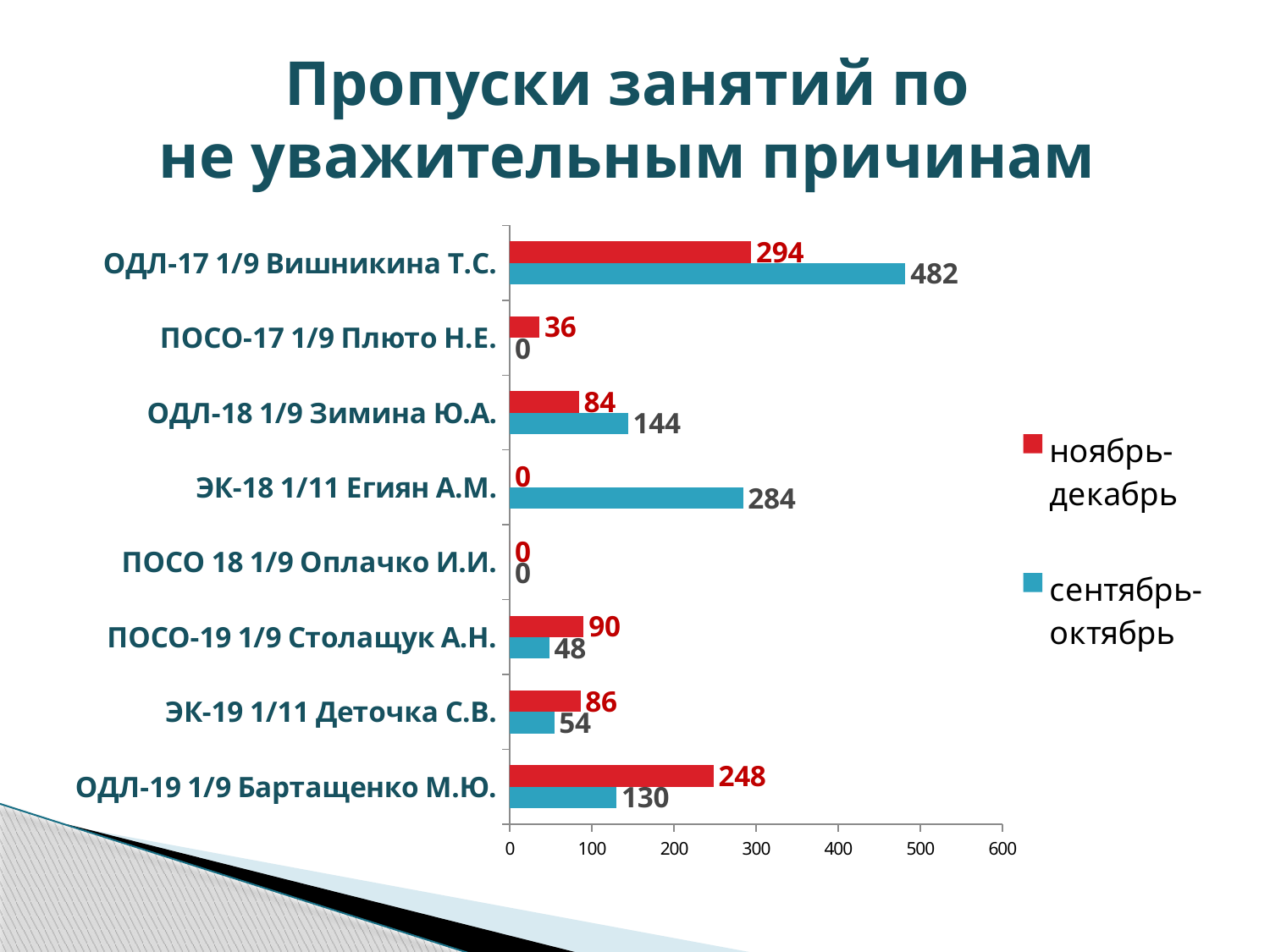
Which category has the highest value in the ноябрь-декабрь series? ОДЛ-17 1/9 Вишникина Т.С. Which category has the highest value in the сентябрь-октябрь series? ОДЛ-17 1/9 Вишникина Т.С. How many categories are shown on the chart? 8 What is the difference between the ноябрь-декабрь and сентябрь-октябрь values for ОДЛ-19 1/9 Бартащенко М.Ю.? 118 What is the value for ОДЛ-19 1/9 Бартащенко М.Ю. in the ноябрь-декабрь series? 248 What kind of chart is shown on the slide? bar chart How many series does the legend list? 2 For ПОСО-19 1/9 Столащук А.Н., which series has the larger value: ноябрь-декабрь or сентябрь-октябрь? ноябрь-декабрь What is the difference between the сентябрь-октябрь and ноябрь-декабрь values for ОДЛ-17 1/9 Вишникина Т.С.? 188 For ОДЛ-18 1/9 Зимина Ю.А., which series has the larger value: ноябрь-декабрь or сентябрь-октябрь? сентябрь-октябрь What is the value for ОДЛ-17 1/9 Вишникина Т.С. in the сентябрь-октябрь series? 482 What is the value for ЭК-18 1/11 Егиян А.М. in the сентябрь-октябрь series? 284